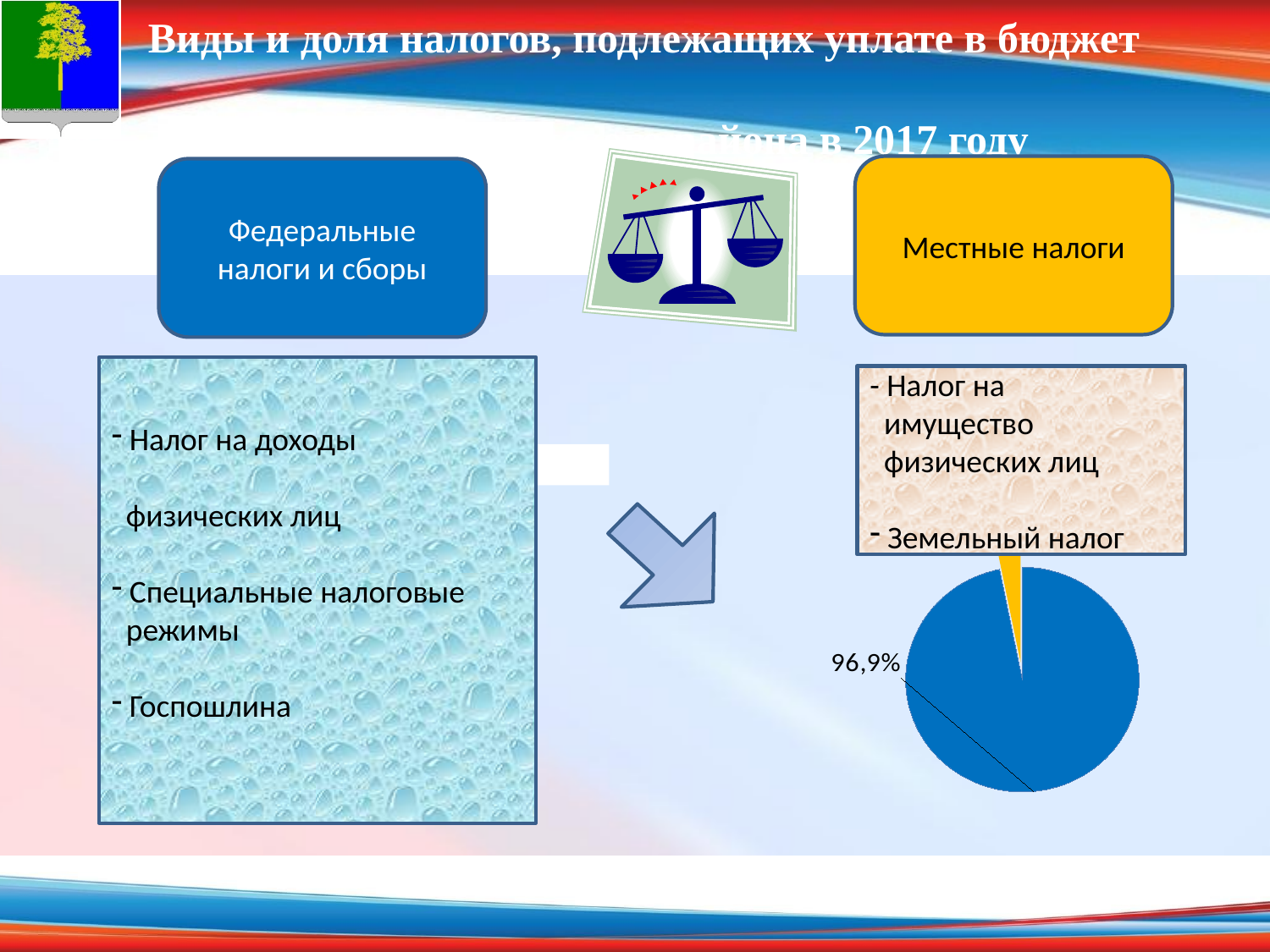
Which slice of the pie chart is larger, the blue one or the yellow one? blue What colour is the smallest slice of the pie chart? yellow What share of the pie does the large blue slice represent? 96,9% How many slices does the pie chart have? 2 What colour is the largest slice of the pie chart? blue What percentage value is printed next to the pie chart? 96,9% What kind of chart is shown in the lower right part of the slide? pie chart